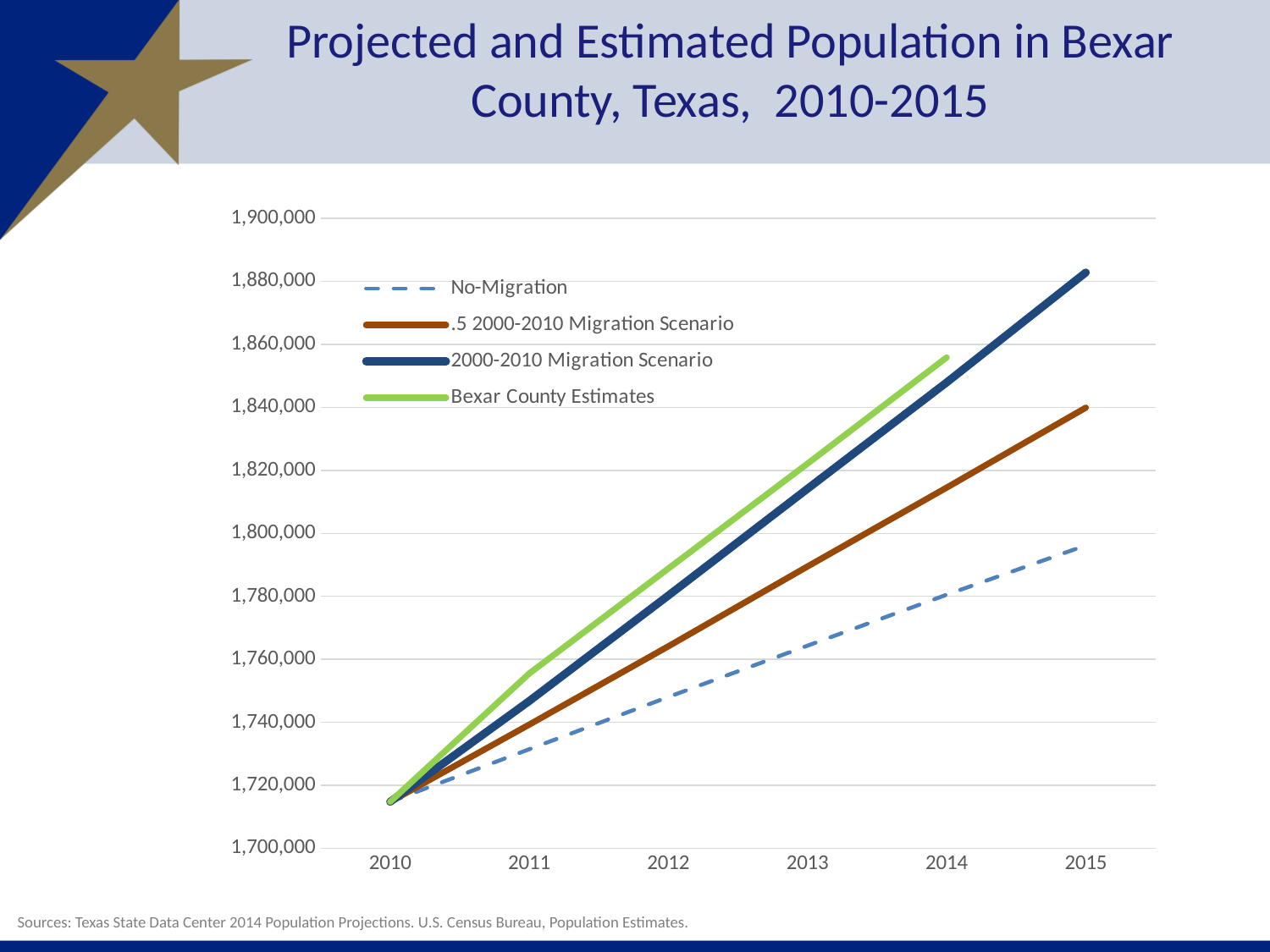
In 2013, which is larger: the .5 2000-2010 Migration Scenario or the No-Migration series? .5 2000-2010 Migration Scenario Which series has the highest value in 2015? 2000-2010 Migration Scenario Is the value for the 2000-2010 Migration Scenario in 2015 greater or less than 1,880,000? greater How many series does the legend list? 4 Which series is drawn with a dashed line? No-Migration What is the title of the chart? Projected and Estimated Population in Bexar County, Texas, 2010-2015 How many years are shown on the x axis? 6 Which series has the lowest value in 2015? No-Migration Do the values for the No-Migration series rise or fall from 2010 to 2015? rise Is the value for Bexar County Estimates in 2014 greater or less than 1,860,000? less Is the value for No-Migration in 2015 greater or less than 1,800,000? less What kind of chart is shown on the slide? line chart